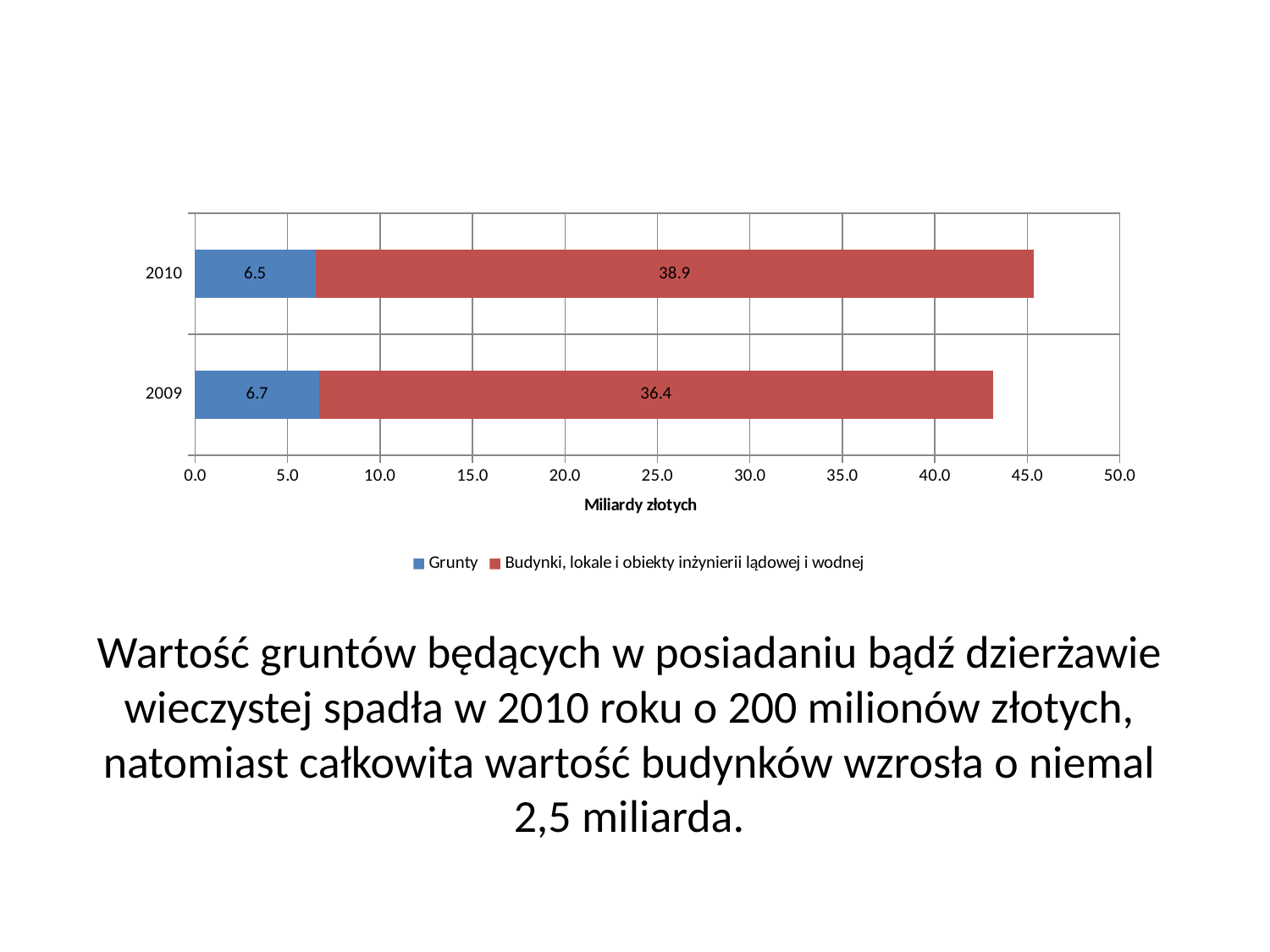
What is the total of the stacked bar for 2010? 45.4 What is the value for Budynki, lokale i obiekty inżynierii lądowej i wodnej in 2009? 36.4 What is the value for Grunty in 2010? 6.5 What is the difference between the Budynki values for 2010 and 2009? 2.5 What is the total of the stacked bar for 2009? 43.1 What is the value for Grunty in 2009? 6.7 How many series does the legend list? 2 What kind of chart is shown on the slide? Stacked bar chart Which year has the higher value for Budynki, lokale i obiekty inżynierii lądowej i wodnej? 2010 Which year has the lower value for Grunty? 2010 What is the value for Budynki, lokale i obiekty inżynierii lądowej i wodnej in 2010? 38.9 What is the x-axis title of the chart? Miliardy złotych